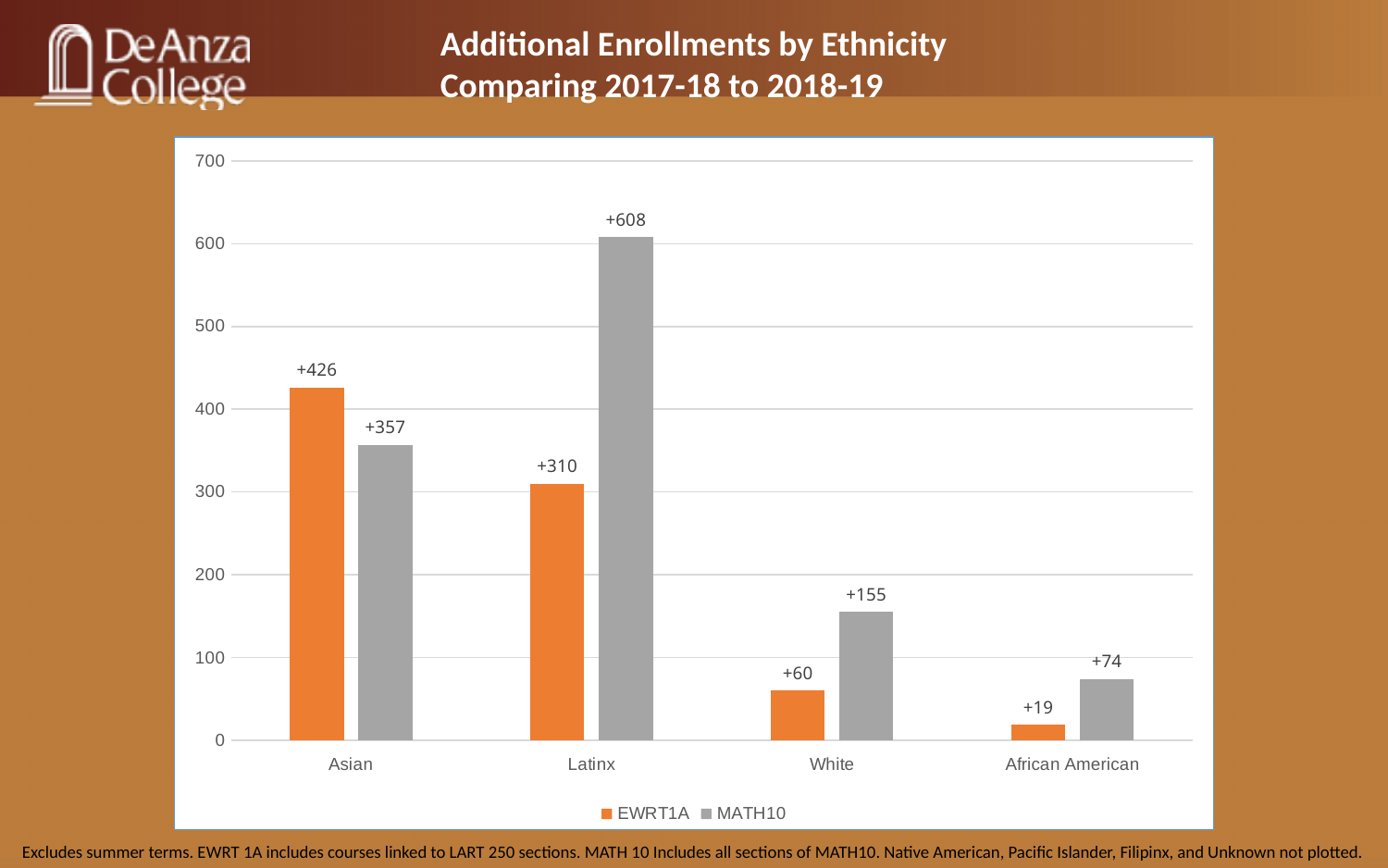
What kind of chart is shown on the slide? Bar chart What colour are the EWRT1A bars? Orange How many ethnicity categories are plotted on the chart? 4 What is the EWRT1A value for African American? +19 What is the MATH10 value for Latinx? +608 What is the MATH10 value for White? +155 Which is larger for Asian, the EWRT1A value or the MATH10 value? EWRT1A Which ethnicity has the lowest EWRT1A value? African American What is the EWRT1A value for Asian? +426 Which ethnicity has the highest MATH10 value? Latinx What is the difference between the MATH10 and EWRT1A values for Latinx? 298 How many series does the legend list? 2